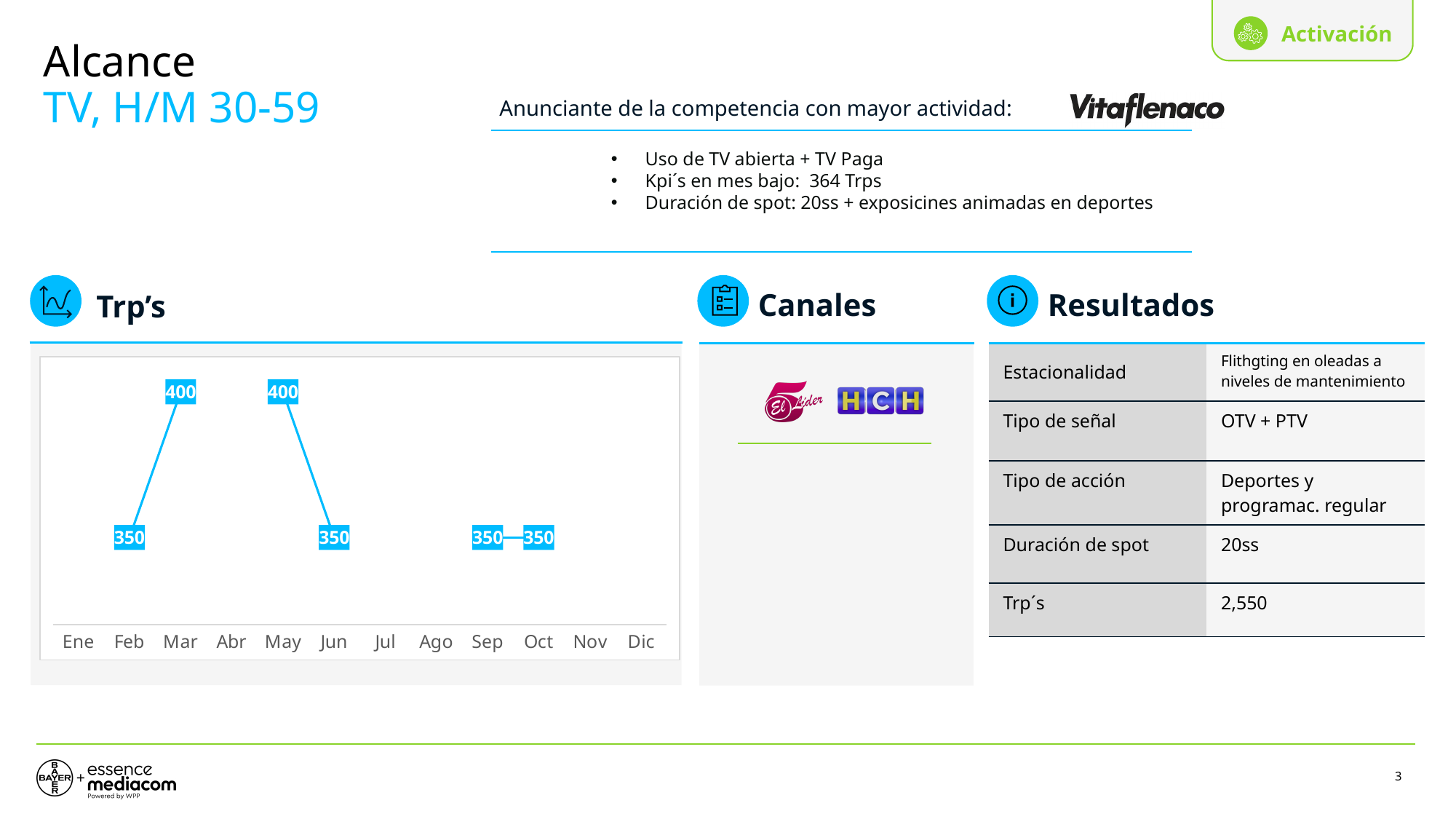
Do the Trp's values rise or fall from May to Jun? fall What is the difference between the Trp's values for Mar and Feb? 50 What is the Trp's value for Jun? 350 How many data points have value labels in the Trp's chart? 6 What is the Trp's value for Oct? 350 How many months are labelled on the x axis of the Trp's chart? 12 What kind of chart is the Trp's chart? line chart What is the Trp's value for Feb? 350 What is the Trp's value for May? 400 What is the highest Trp's value shown in the chart? 400 Which is larger, the Trp's value for May or for Jun? May What is the Trp's value for Mar? 400